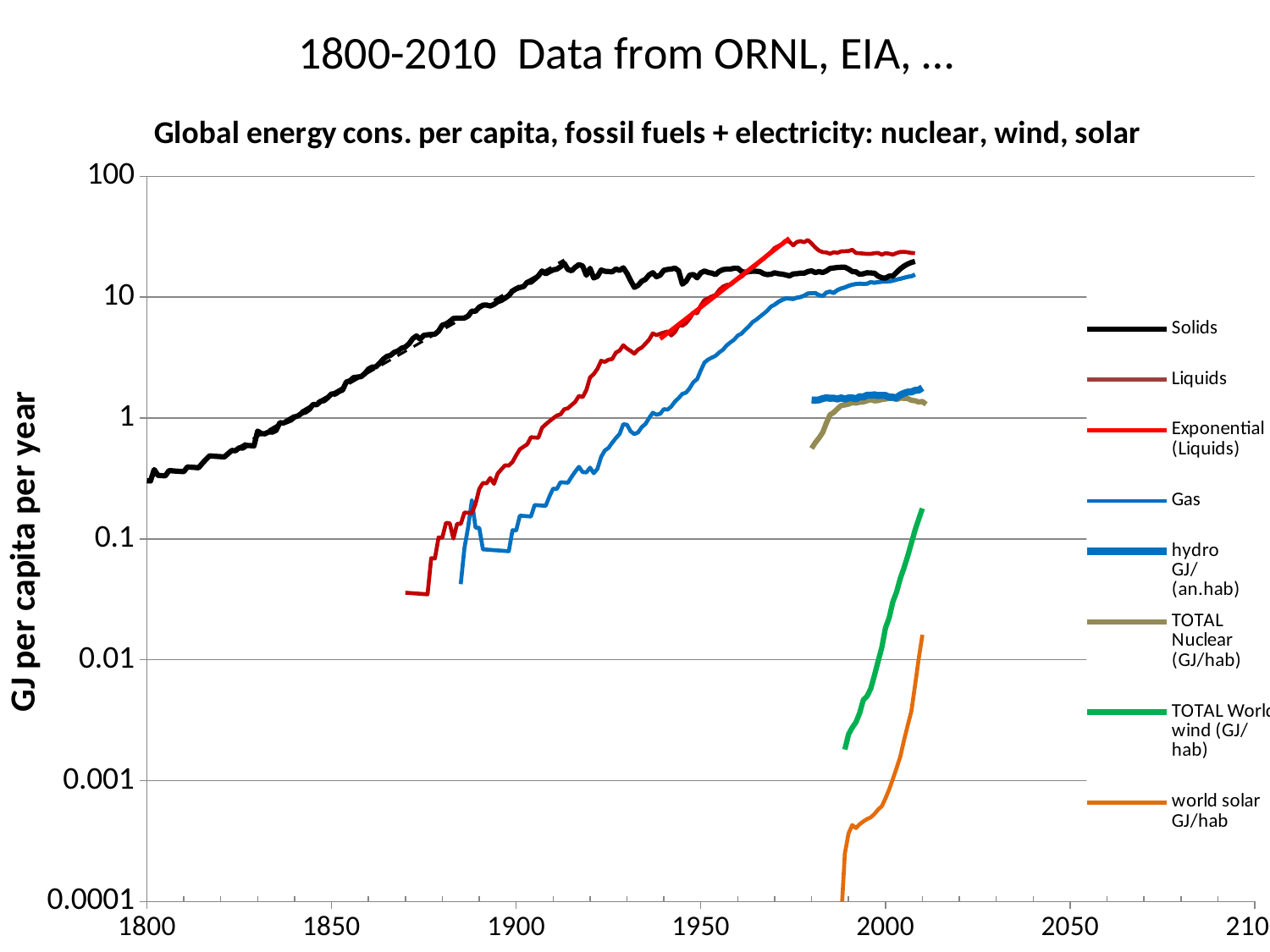
Which is larger in 1900, the value for Solids or the value for Gas? Solids What is the label on the vertical axis? GJ per capita per year Is the value for Gas in 1900 greater or less than 1? less What is the chart's title? Global energy cons. per capita, fossil fuels + electricity: nuclear, wind, solar Is the value for Solids in 1800 greater or less than 1? less Which is larger in 2010, the value for TOTAL World wind (GJ/hab) or the value for world solar GJ/hab? TOTAL World wind (GJ/hab) Does the Solids series rise or fall between 1800 and 1900? rise Is the value for world solar GJ/hab in 2010 greater or less than 0.1? less How many series does the legend list? 8 What kind of chart is shown on the slide? line chart